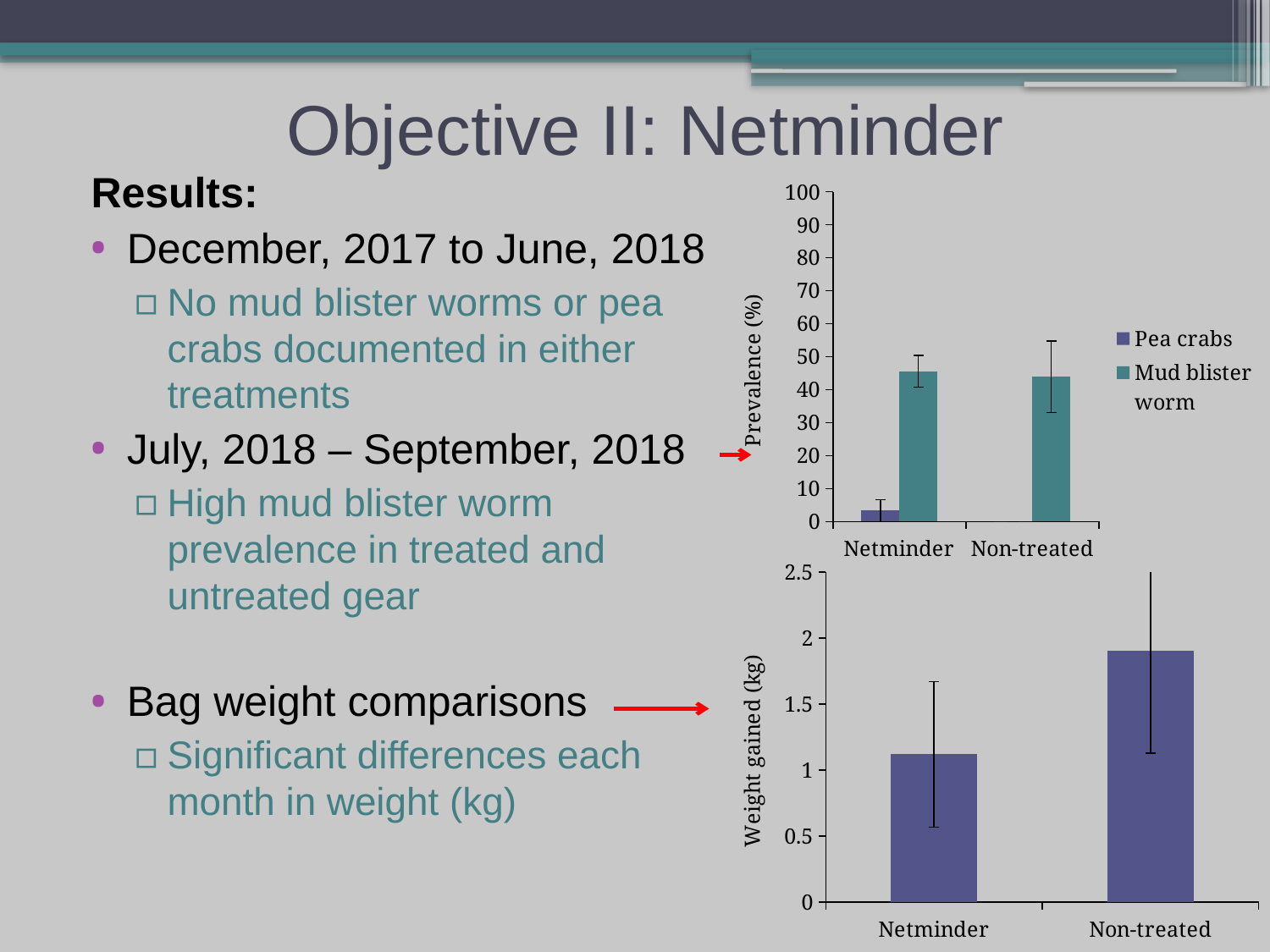
In the top chart (Prevalence (%)), is the Mud blister worm value for Netminder greater or less than 30? greater What kind of chart is the top chart (Prevalence (%))? bar chart In the top chart (Prevalence (%)), which series has the higher value for Netminder, Pea crabs or Mud blister worm? Mud blister worm In the bottom chart (Weight gained (kg)), is the value for Netminder greater or less than 1.5? less In the top chart (Prevalence (%)), how many series does the legend list? 2 In the top chart (Prevalence (%)), what are the two series named in the legend? Pea crabs and Mud blister worm In the top chart (Prevalence (%)), is the Pea crabs value for Netminder greater or less than 10? less In the bottom chart (Weight gained (kg)), which category has the lowest value? Netminder What kind of chart is the bottom chart (Weight gained (kg))? bar chart In the top chart (Prevalence (%)), how many categories are shown on the x axis? 2 In the bottom chart (Weight gained (kg)), which category has the highest value? Non-treated